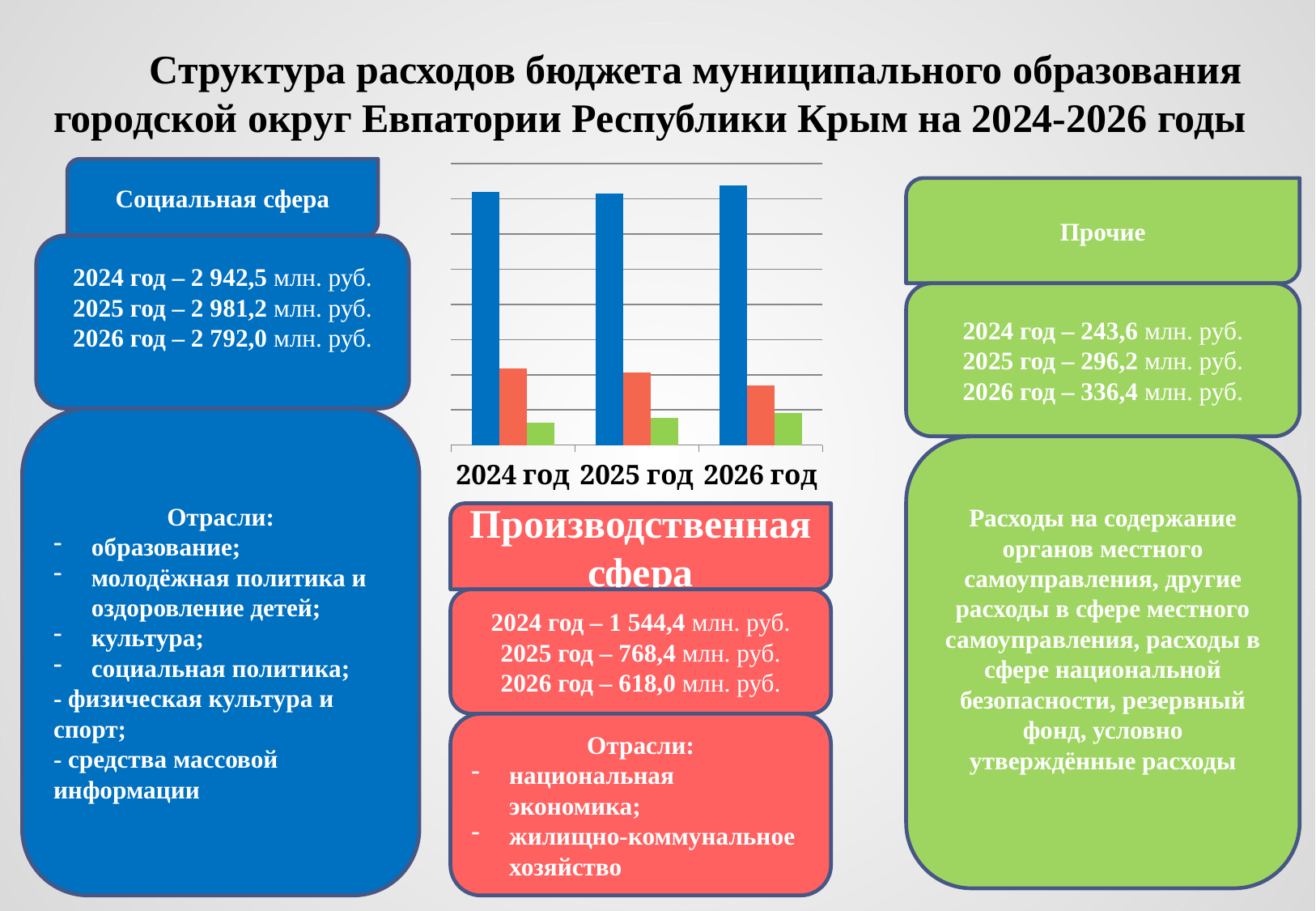
Do the green bars rise or fall from 2024 год to 2026 год? rise In the chart, which is larger for 2024 год: the blue bar or the orange bar? the blue bar What kind of chart is shown on the slide? bar chart Do the orange bars rise or fall from 2024 год to 2026 год? fall In the chart, which is larger for 2026 год: the orange bar or the green bar? the orange bar What are the category labels on the x axis of the chart? 2024 год, 2025 год, 2026 год How many bars are shown for each year in the chart? 3 How many categories are shown on the x axis of the chart? 3 Which colour of bar is the tallest in every year group of the chart? blue In the chart, which year has the lowest orange bar? 2026 год